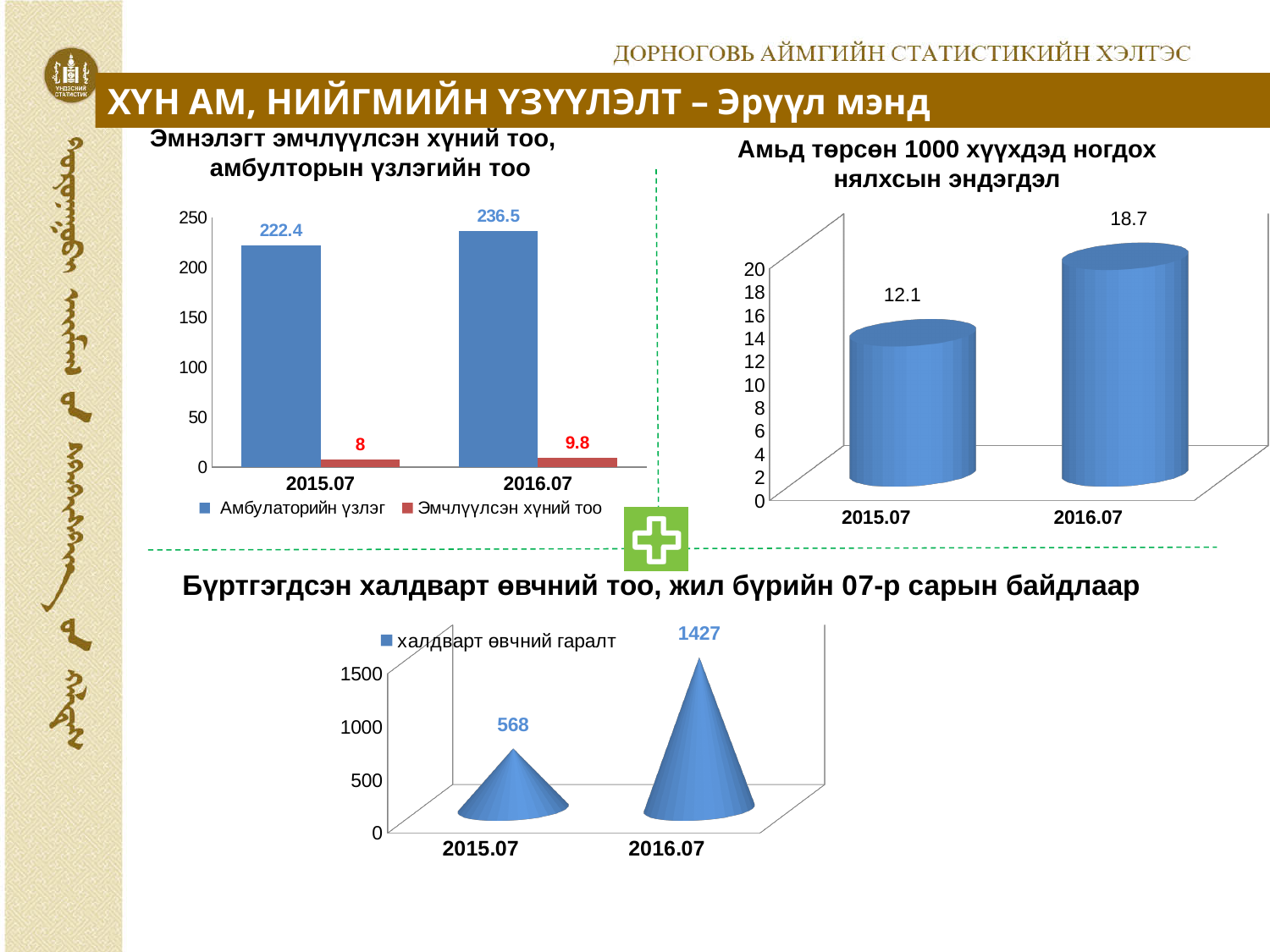
In the bottom chart (Бүртгэгдсэн халдварт өвчний тоо), how many categories are shown on the x axis? 2 In the top-left chart (Эмнэлэгт эмчлүүлсэн хүний тоо, амбулторын үзлэгийн тоо), how many series does the legend list? 2 In the top-left chart (Эмнэлэгт эмчлүүлсэн хүний тоо, амбулторын үзлэгийн тоо), what is the value of Амбулаторийн үзлэг for 2015.07? 222.4 In the top-right chart (Амьд төрсөн 1000 хүүхдэд ногдох нялхсын эндэгдэл), what is the difference between the 2016.07 and 2015.07 values? 6.6 In the top-left chart (Эмнэлэгт эмчлүүлсэн хүний тоо, амбулторын үзлэгийн тоо), what is the value of Эмчлүүлсэн хүний тоо for 2016.07? 9.8 In the top-left chart (Эмнэлэгт эмчлүүлсэн хүний тоо, амбулторын үзлэгийн тоо), does the Амбулаторийн үзлэг series rise or fall from 2015.07 to 2016.07? rise In the top-right chart (Амьд төрсөн 1000 хүүхдэд ногдох нялхсын эндэгдэл), what is the value for 2016.07? 18.7 In the bottom chart (Бүртгэгдсэн халдварт өвчний тоо), what series name does the legend show? халдварт өвчний гаралт In the top-right chart (Амьд төрсөн 1000 хүүхдэд ногдох нялхсын эндэгдэл), which year has the lowest value? 2015.07 In the bottom chart (Бүртгэгдсэн халдварт өвчний тоо), what is the value for 2015.07? 568 In the bottom chart (Бүртгэгдсэн халдварт өвчний тоо), which year has the highest value? 2016.07 In the top-left chart (Эмнэлэгт эмчлүүлсэн хүний тоо, амбулторын үзлэгийн тоо), what is the difference between the Амбулаторийн үзлэг values for 2016.07 and 2015.07? 14.1